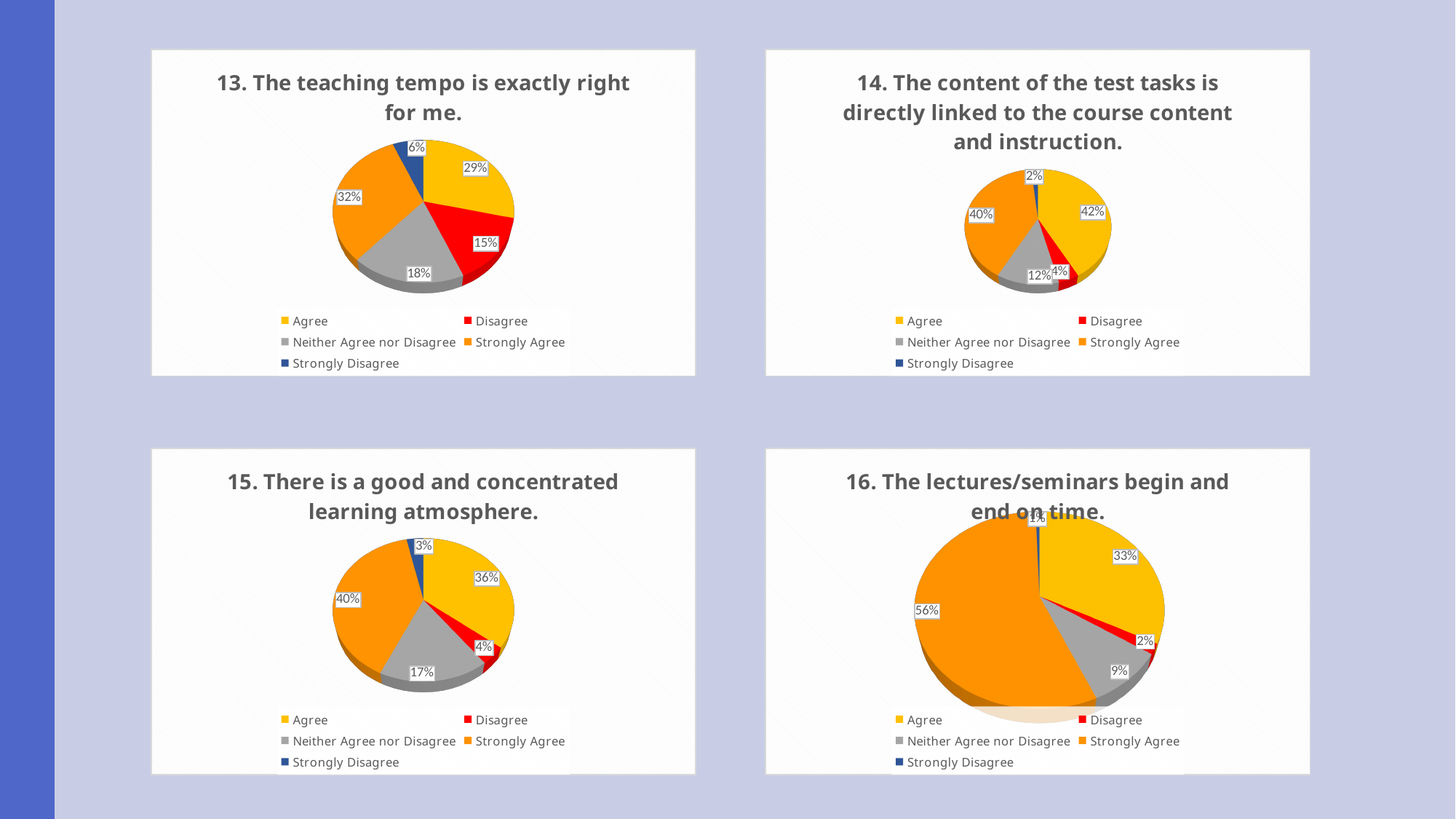
In the chart titled "16. The lectures/seminars begin and end on time.", what is the difference between the Strongly Agree and Agree shares? 23% In the chart titled "13. The teaching tempo is exactly right for me.", what percentage is shown for Strongly Agree? 32% In the chart titled "16. The lectures/seminars begin and end on time.", which is larger, the Agree share or the Neither Agree nor Disagree share? Agree In the chart titled "13. The teaching tempo is exactly right for me.", what percentage is shown for Disagree? 15% What type of chart is used for "15. There is a good and concentrated learning atmosphere."? Pie chart In the chart titled "14. The content of the test tasks is directly linked to the course content and instruction.", what is the difference between the Agree and Strongly Agree shares? 2% In the chart titled "15. There is a good and concentrated learning atmosphere.", what percentage is shown for Neither Agree nor Disagree? 17% In the chart titled "15. There is a good and concentrated learning atmosphere.", which response has the largest share? Strongly Agree In the chart titled "13. The teaching tempo is exactly right for me.", which response has the smallest share? Strongly Disagree In the chart titled "14. The content of the test tasks is directly linked to the course content and instruction.", what percentage is shown for Agree? 42% How many response categories does the legend list in the chart titled "13. The teaching tempo is exactly right for me."? 5 In the chart titled "16. The lectures/seminars begin and end on time.", what percentage is shown for Strongly Agree? 56%